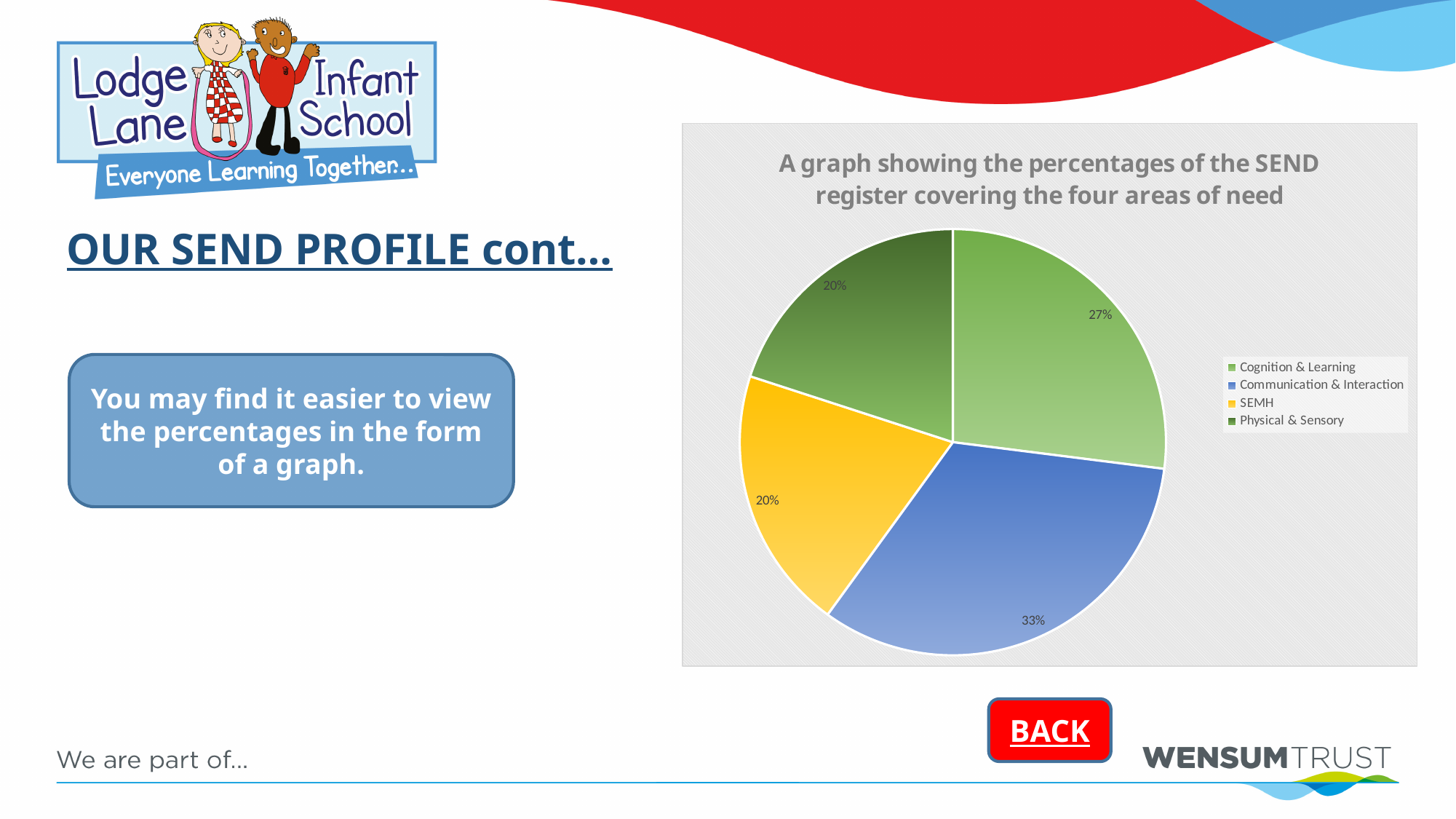
Which is larger, the share for Cognition & Learning or the share for SEMH? Cognition & Learning What is the difference in percentage points between Communication & Interaction and Cognition & Learning? 6 How many entries does the legend list? 4 What is the title of the chart? A graph showing the percentages of the SEND register covering the four areas of need What percentage of the SEND register is Communication & Interaction? 33% What percentage of the SEND register is SEMH? 20% What percentage of the SEND register is Physical & Sensory? 20% What kind of chart is shown on the slide? Pie chart Which area of need has the largest share of the SEND register? Communication & Interaction What colour is the SEMH slice in the pie chart? Yellow What percentage of the SEND register is Cognition & Learning? 27% How many areas of need are shown in the pie chart? 4